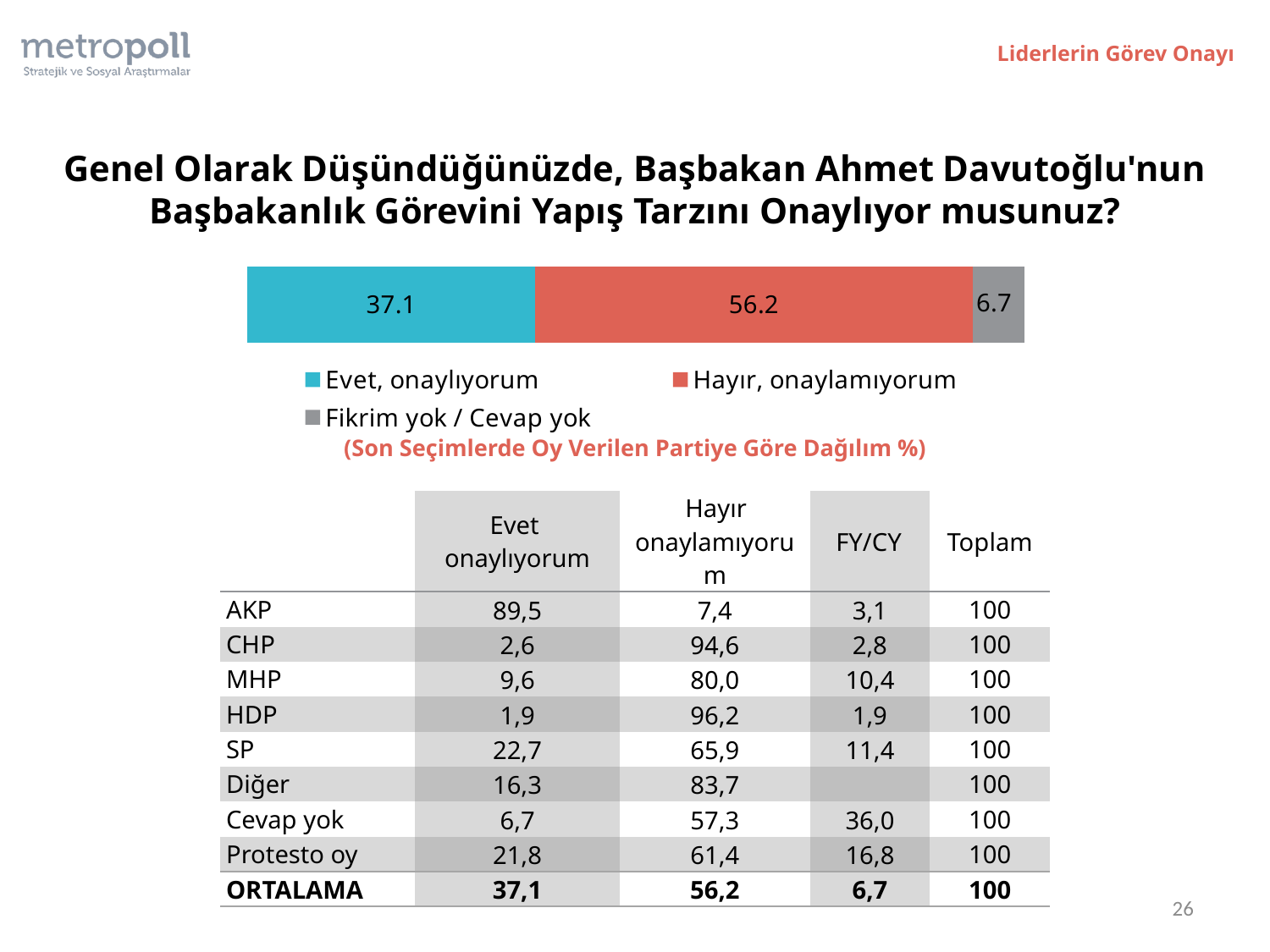
How many series does the legend of the stacked bar chart list? 3 What colour is the "Hayır, onaylamıyorum" segment in the stacked bar chart? Red What value is shown for "Fikrim yok / Cevap yok" in the stacked bar chart? 6.7 What is the difference between the "Hayır, onaylamıyorum" and "Evet, onaylıyorum" values in the stacked bar chart? 19.1 What is the total of the three segments in the stacked bar? 100 What value is shown for "Evet, onaylıyorum" in the stacked bar chart? 37.1 Which response category has the largest segment in the stacked bar chart? Hayır, onaylamıyorum Which is larger in the stacked bar chart: "Evet, onaylıyorum" or "Hayır, onaylamıyorum"? Hayır, onaylamıyorum What colour is the "Evet, onaylıyorum" segment in the stacked bar chart? Blue What value is shown for "Hayır, onaylamıyorum" in the stacked bar chart? 56.2 What kind of chart is shown on the slide? Stacked bar chart Which response category has the smallest segment in the stacked bar chart? Fikrim yok / Cevap yok